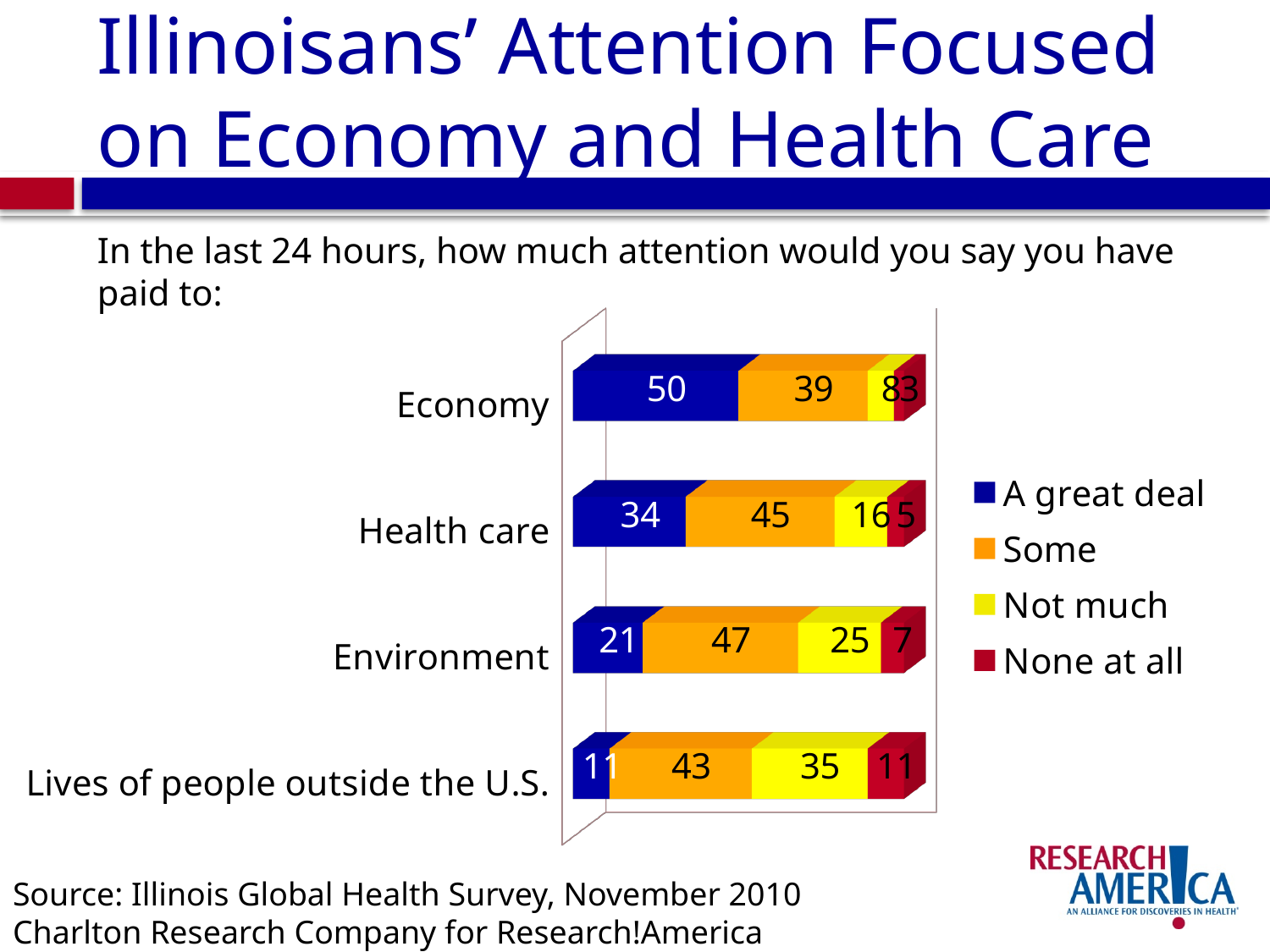
Which has a larger 'Not much' value, Health care or Environment? Environment How many series does the legend list? 4 What is the 'Not much' value for Environment? 25 What is the 'Some' value for Health care? 45 What percentage of Illinoisans said they paid 'A great deal' of attention to the Economy? 50 What kind of chart is shown on the slide? Stacked bar chart Which category has the highest 'A great deal' value? Economy How many categories are shown in the chart? 4 How much larger is the 'Some' value for Environment than the 'Some' value for Economy? 8 What is the 'None at all' value for Lives of people outside the U.S.? 11 What is the total of the stacked bar for Health care? 100 Which category has the lowest 'A great deal' value? Lives of people outside the U.S.